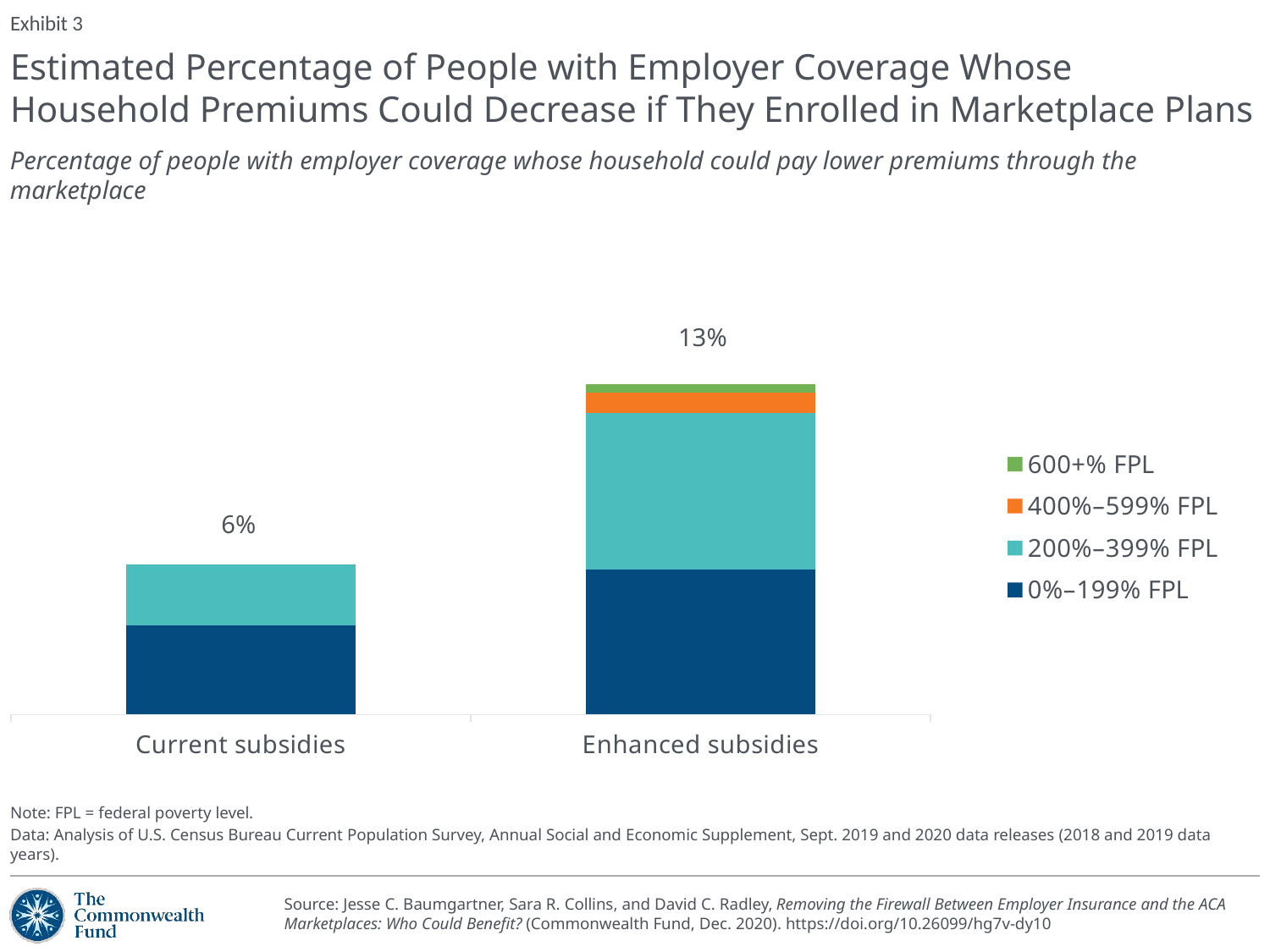
Is the total for Enhanced subsidies larger or smaller than the total for Current subsidies? Larger What colour represents the 600+% FPL series in the legend? Green How many series does the legend list? 4 What is the total value shown for the Enhanced subsidies bar? 13% Which category has the lower total percentage? Current subsidies Which series forms the bottom segment of each bar? 0%–199% FPL How many visible segments does the Current subsidies bar have? 2 What is the total value shown for the Current subsidies bar? 6% How many categories are shown on the x axis? 2 What is the difference between the Enhanced subsidies total and the Current subsidies total? 7 percentage points Which category has the higher total percentage? Enhanced subsidies What kind of chart is shown on the slide? Stacked bar chart